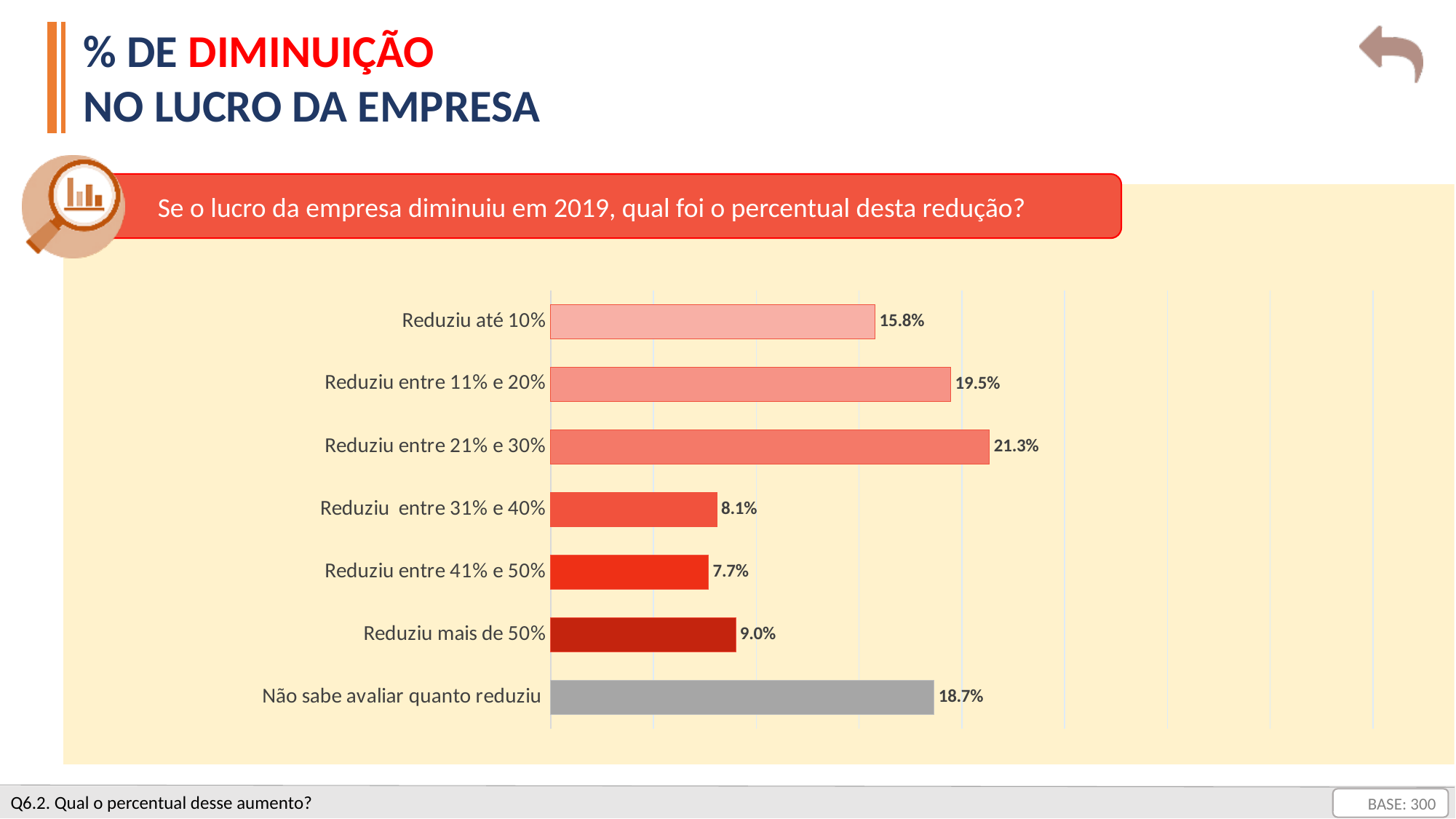
What is the value for "Reduziu mais de 50%"? 9.0% How many categories are shown in the chart? 7 What is the value for "Reduziu até 10%"? 15.8% What is the value for "Reduziu entre 21% e 30%"? 21.3% Which category has the highest value? Reduziu entre 21% e 30% What is the difference between the values for "Reduziu entre 11% e 20%" and "Reduziu até 10%"? 3.7% What is the difference between the values for "Reduziu entre 21% e 30%" and "Reduziu entre 41% e 50%"? 13.6% What is the value for "Não sabe avaliar quanto reduziu"? 18.7% Which category has the lowest value? Reduziu entre 41% e 50% Which is larger: the value for "Reduziu entre 31% e 40%" or "Reduziu mais de 50%"? Reduziu mais de 50% What colour is the bar for "Não sabe avaliar quanto reduziu"? Grey What kind of chart is shown on the slide? Bar chart